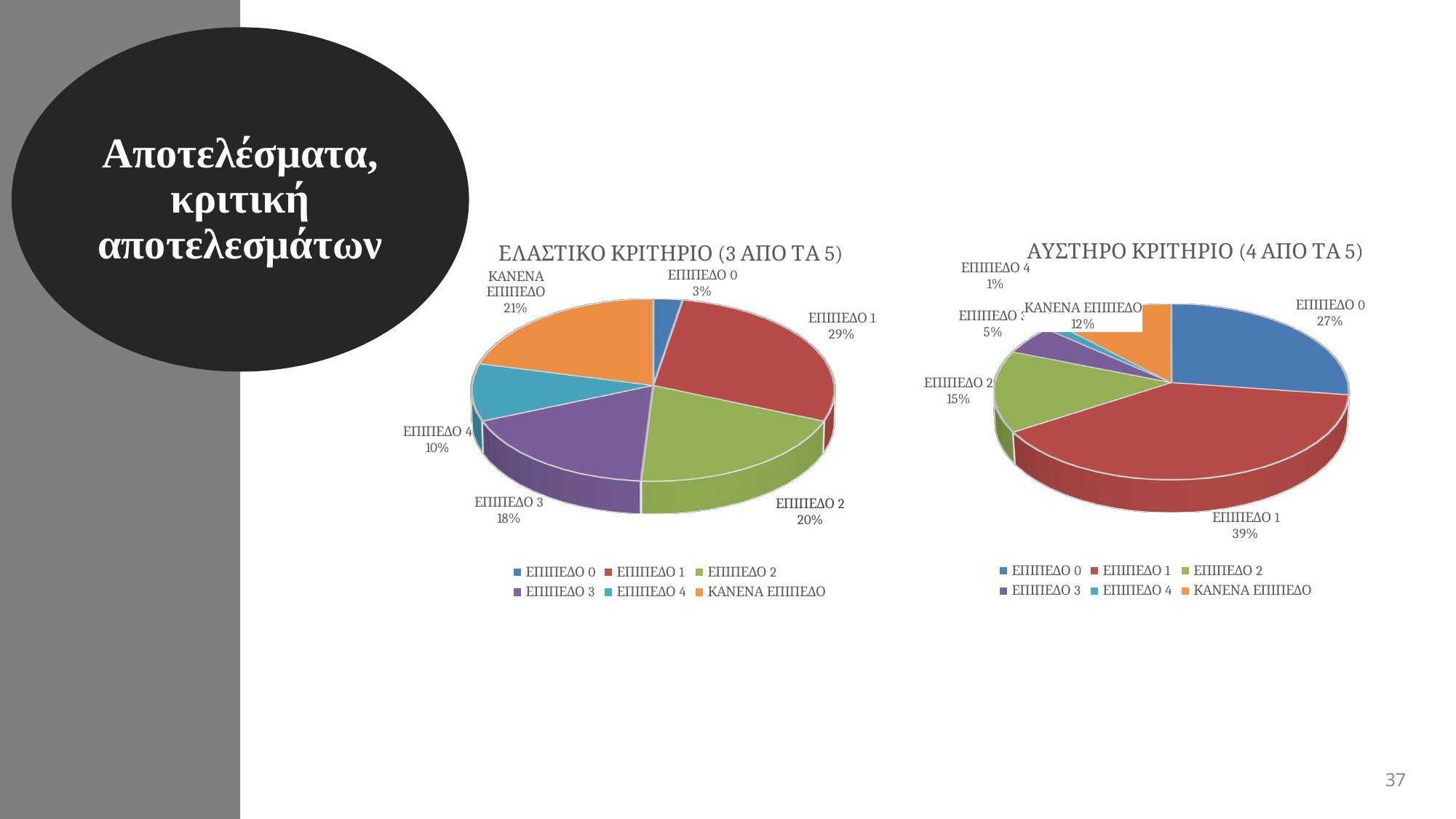
In the ΑΥΣΤΗΡΟ ΚΡΙΤΗΡΙΟ (4 ΑΠΟ ΤΑ 5) chart, which is larger, ΕΠΙΠΕΔΟ 0 or ΕΠΙΠΕΔΟ 2? ΕΠΙΠΕΔΟ 0 What type of chart is the ΕΛΑΣΤΙΚΟ ΚΡΙΤΗΡΙΟ (3 ΑΠΟ ΤΑ 5) chart? Pie chart In the ΑΥΣΤΗΡΟ ΚΡΙΤΗΡΙΟ (4 ΑΠΟ ΤΑ 5) chart, what is the difference between ΕΠΙΠΕΔΟ 1 and ΕΠΙΠΕΔΟ 0? 12% In the ΑΥΣΤΗΡΟ ΚΡΙΤΗΡΙΟ (4 ΑΠΟ ΤΑ 5) chart, what is the value for ΕΠΙΠΕΔΟ 1? 39% How many entries does the legend of the ΑΥΣΤΗΡΟ ΚΡΙΤΗΡΙΟ (4 ΑΠΟ ΤΑ 5) chart list? 6 In the ΕΛΑΣΤΙΚΟ ΚΡΙΤΗΡΙΟ (3 ΑΠΟ ΤΑ 5) chart, what is the value for ΚΑΝΕΝΑ ΕΠΙΠΕΔΟ? 21% In the ΕΛΑΣΤΙΚΟ ΚΡΙΤΗΡΙΟ (3 ΑΠΟ ΤΑ 5) chart, which category has the smallest slice? ΕΠΙΠΕΔΟ 0 In the ΕΛΑΣΤΙΚΟ ΚΡΙΤΗΡΙΟ (3 ΑΠΟ ΤΑ 5) chart, which category has the largest slice? ΕΠΙΠΕΔΟ 1 How many categories does the ΕΛΑΣΤΙΚΟ ΚΡΙΤΗΡΙΟ (3 ΑΠΟ ΤΑ 5) chart show? 6 In the ΑΥΣΤΗΡΟ ΚΡΙΤΗΡΙΟ (4 ΑΠΟ ΤΑ 5) chart, which category has the smallest slice? ΕΠΙΠΕΔΟ 4 In the ΕΛΑΣΤΙΚΟ ΚΡΙΤΗΡΙΟ (3 ΑΠΟ ΤΑ 5) chart, what is the difference between ΕΠΙΠΕΔΟ 3 and ΕΠΙΠΕΔΟ 4? 8% In the ΕΛΑΣΤΙΚΟ ΚΡΙΤΗΡΙΟ (3 ΑΠΟ ΤΑ 5) chart, what share does ΕΠΙΠΕΔΟ 1 have? 29%